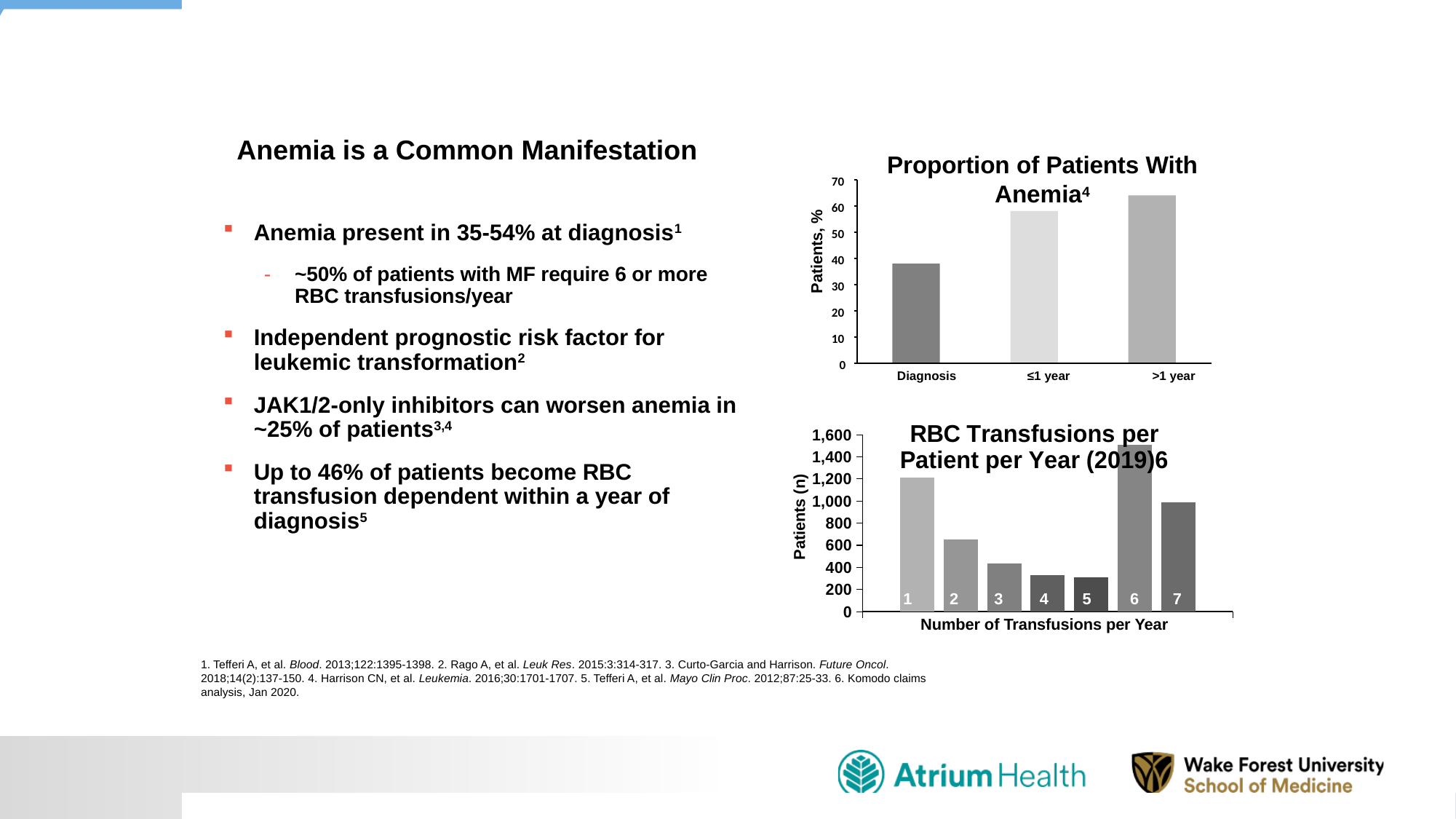
In the 'Proportion of Patients With Anemia' chart, which category has the lowest value? Diagnosis In the 'RBC Transfusions per Patient per Year (2019)' chart, which is larger, the value for 2 transfusions per year or for 7 transfusions per year? 7 In the 'Proportion of Patients With Anemia' chart, what is the y-axis label? Patients, % In the 'Proportion of Patients With Anemia' chart, which category has the highest value? >1 year In the 'Proportion of Patients With Anemia' chart, do the values rise or fall from Diagnosis to >1 year? Rise In the 'Proportion of Patients With Anemia' chart, how many categories are plotted? 3 In the 'RBC Transfusions per Patient per Year (2019)' chart, which number of transfusions per year has the highest number of patients? 6 In the 'Proportion of Patients With Anemia' chart, what kind of chart is shown? Bar chart In the 'RBC Transfusions per Patient per Year (2019)' chart, how many bars are plotted? 7 In the 'Proportion of Patients With Anemia' chart, is the value for >1 year greater or less than 60? greater In the 'RBC Transfusions per Patient per Year (2019)' chart, is the value for 1 transfusion per year greater or less than 1,000? greater